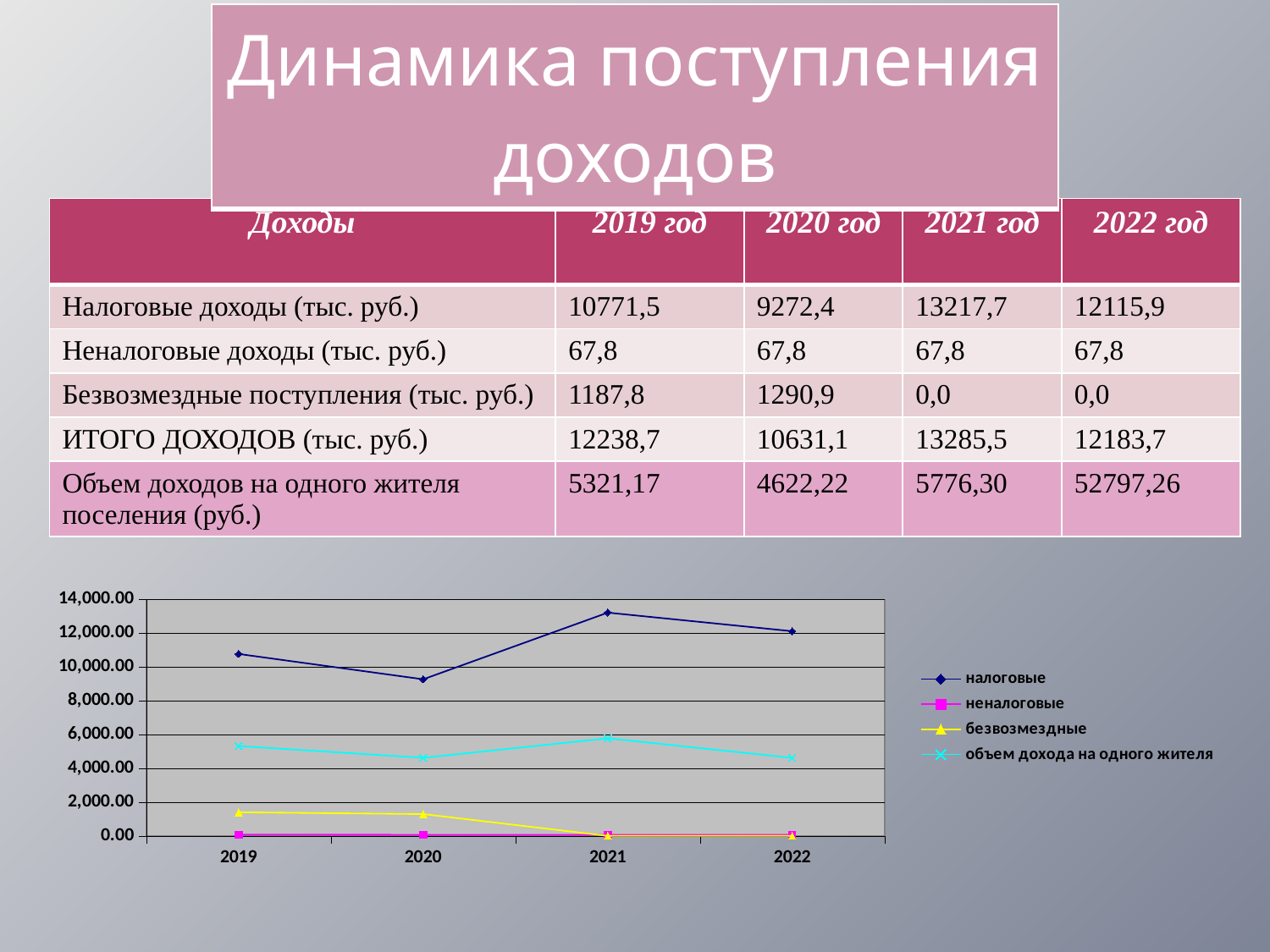
In 2021, which series is higher on the chart: налоговые or объем дохода на одного жителя? налоговые Which series is drawn with yellow triangle markers in the chart? безвозмездные In which year does the налоговые series reach its lowest point on the chart? 2020 Does the безвозмездные series rise or fall from 2020 to 2021? fall How many series does the chart's legend list? 4 Is the value for налоговые in 2020 greater or less than 10,000.00? less How many years are plotted along the x axis of the chart? 4 Does the налоговые series rise or fall from 2020 to 2021? rise Is the value for налоговые in 2019 greater or less than 10,000.00? greater Is the value for безвозмездные in 2019 greater or less than 2,000.00? less In which year does the налоговые series reach its highest point on the chart? 2021 What kind of chart is shown at the bottom of the slide? line chart